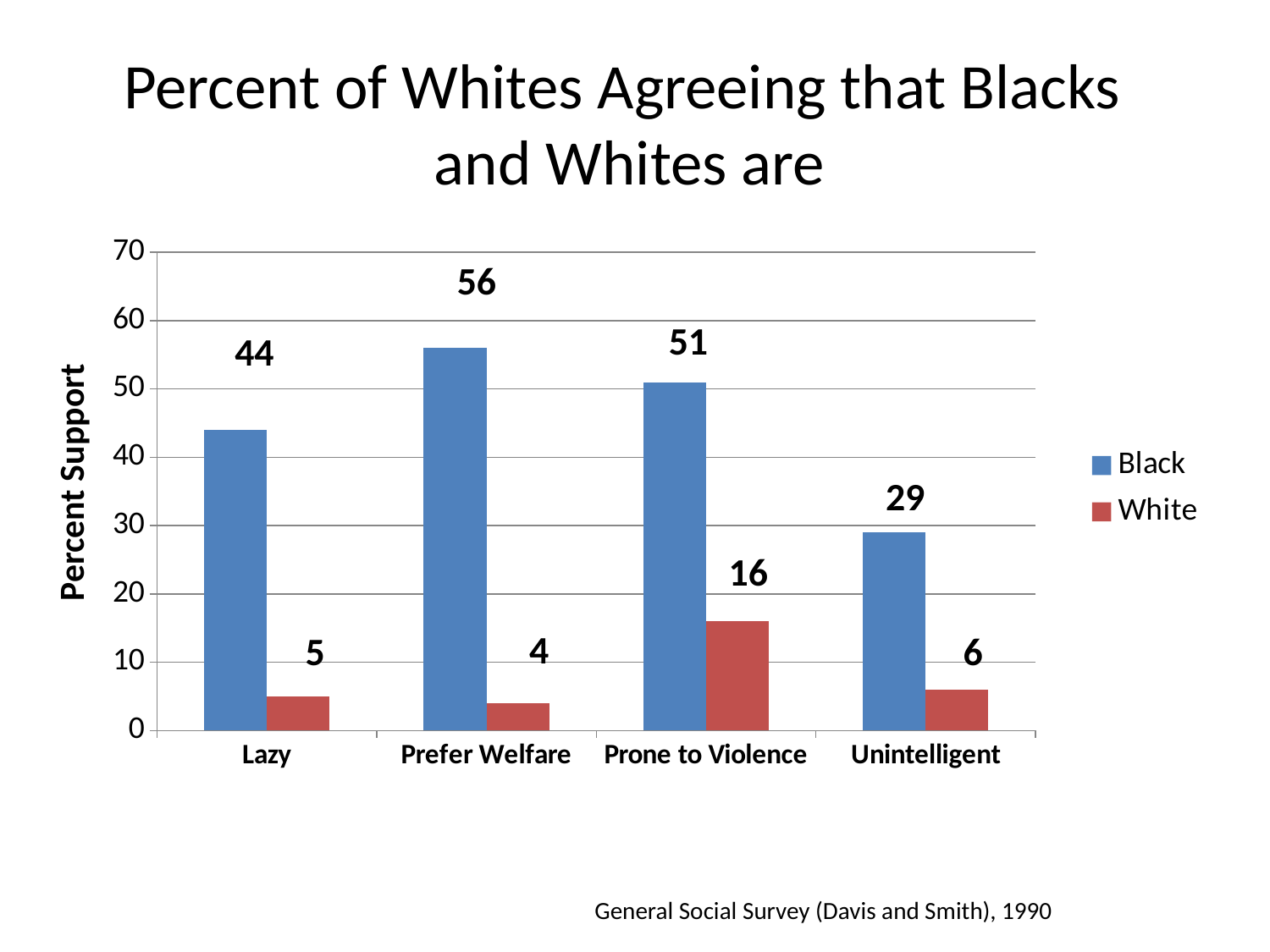
How many series does the legend list? 2 Which category has the lowest value for the White series? Prefer Welfare What is the label of the y axis? Percent Support What kind of chart is shown on the slide? bar chart What is the difference between the Black and White values in the Lazy category? 39 Is the Black value for Unintelligent greater or less than 30? less Which is larger: the Black value for Lazy or the Black value for Prone to Violence? Prone to Violence How many categories are shown on the x axis? 4 What is the value for Black in the Prefer Welfare category? 56 Which category has the highest value for the Black series? Prefer Welfare What is the value for White in the Prone to Violence category? 16 What is the value for Black in the Unintelligent category? 29